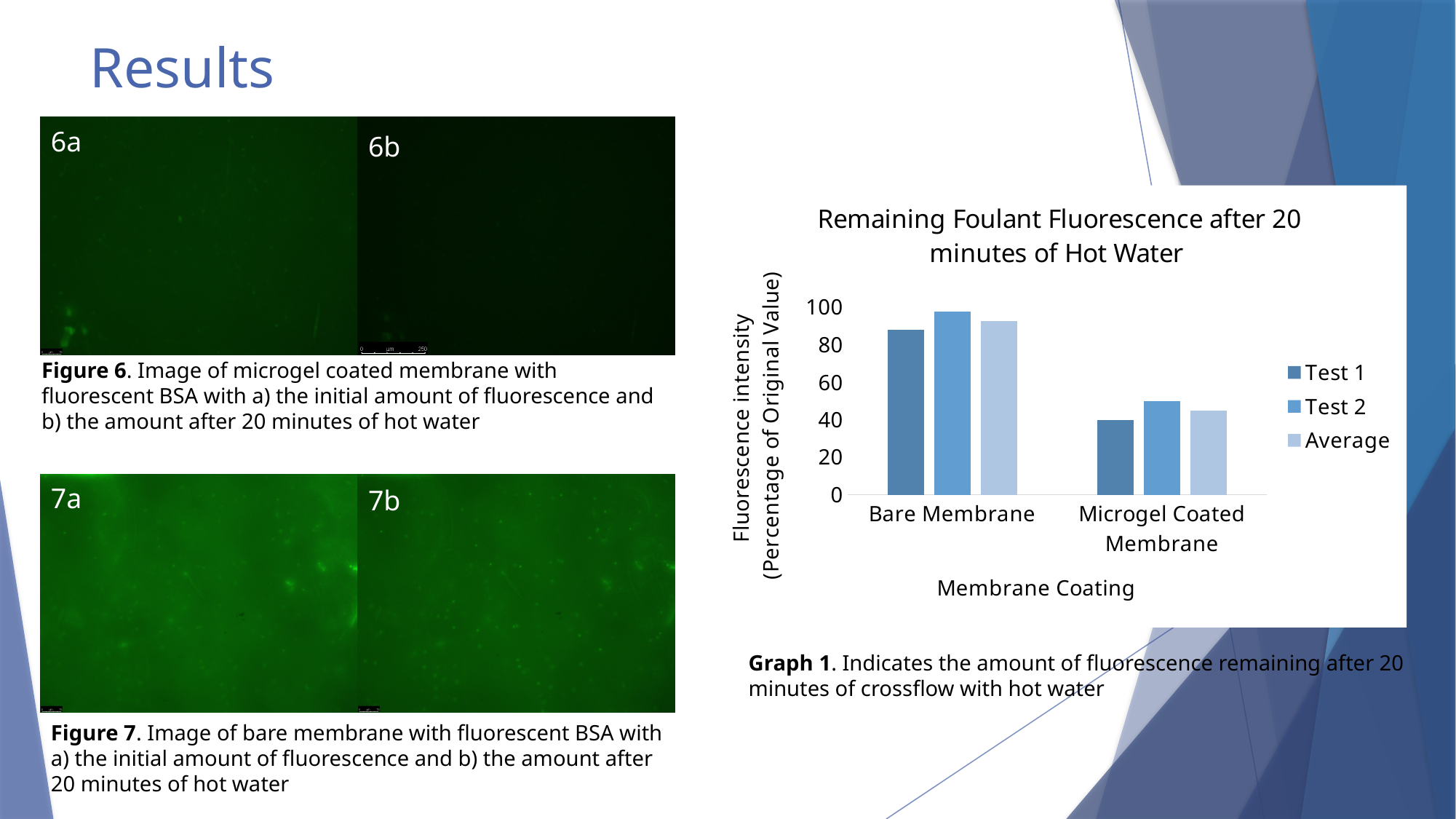
Is the Test 1 value for Microgel Coated Membrane greater or less than 60? less What is the title of the chart on the slide? Remaining Foulant Fluorescence after 20 minutes of Hot Water Which category has the lower Average value? Microgel Coated Membrane How many series does the legend of the chart list? 3 What type of chart is Graph 1 on the slide? bar chart For Microgel Coated Membrane, which series has the lowest bar? Test 1 Is the Average value for Microgel Coated Membrane greater or less than 20? greater What is the x-axis label of the chart? Membrane Coating How many categories are shown on the x axis of the chart? 2 Is the Test 1 value for Bare Membrane greater or less than 80? greater Which category has the higher Test 1 value, Bare Membrane or Microgel Coated Membrane? Bare Membrane For Bare Membrane, which series has the highest bar? Test 2